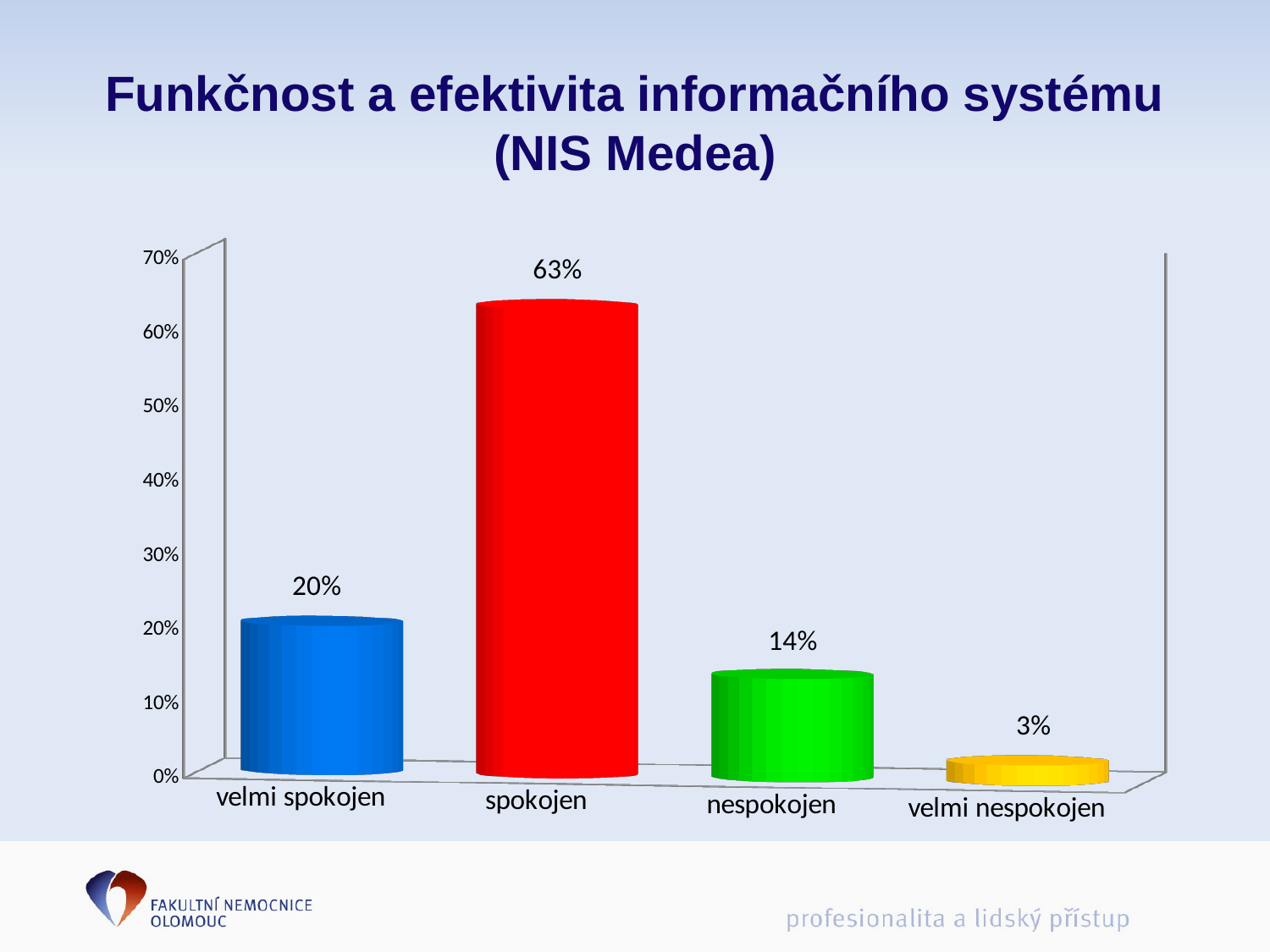
What is the difference between the values for "spokojen" and "velmi spokojen"? 43% How many categories are shown on the x axis? 4 What is the value for "velmi nespokojen"? 3% What is the difference between the values for "nespokojen" and "velmi nespokojen"? 11% Which category has the highest value? spokojen What is the value for "velmi spokojen"? 20% What is the title of the chart? Funkčnost a efektivita informačního systému (NIS Medea) Which is larger, the value for "velmi spokojen" or the value for "nespokojen"? velmi spokojen Which category has the lowest value? velmi nespokojen What kind of chart is shown on the slide? bar chart What is the value for "nespokojen"? 14% What is the value for "spokojen"? 63%